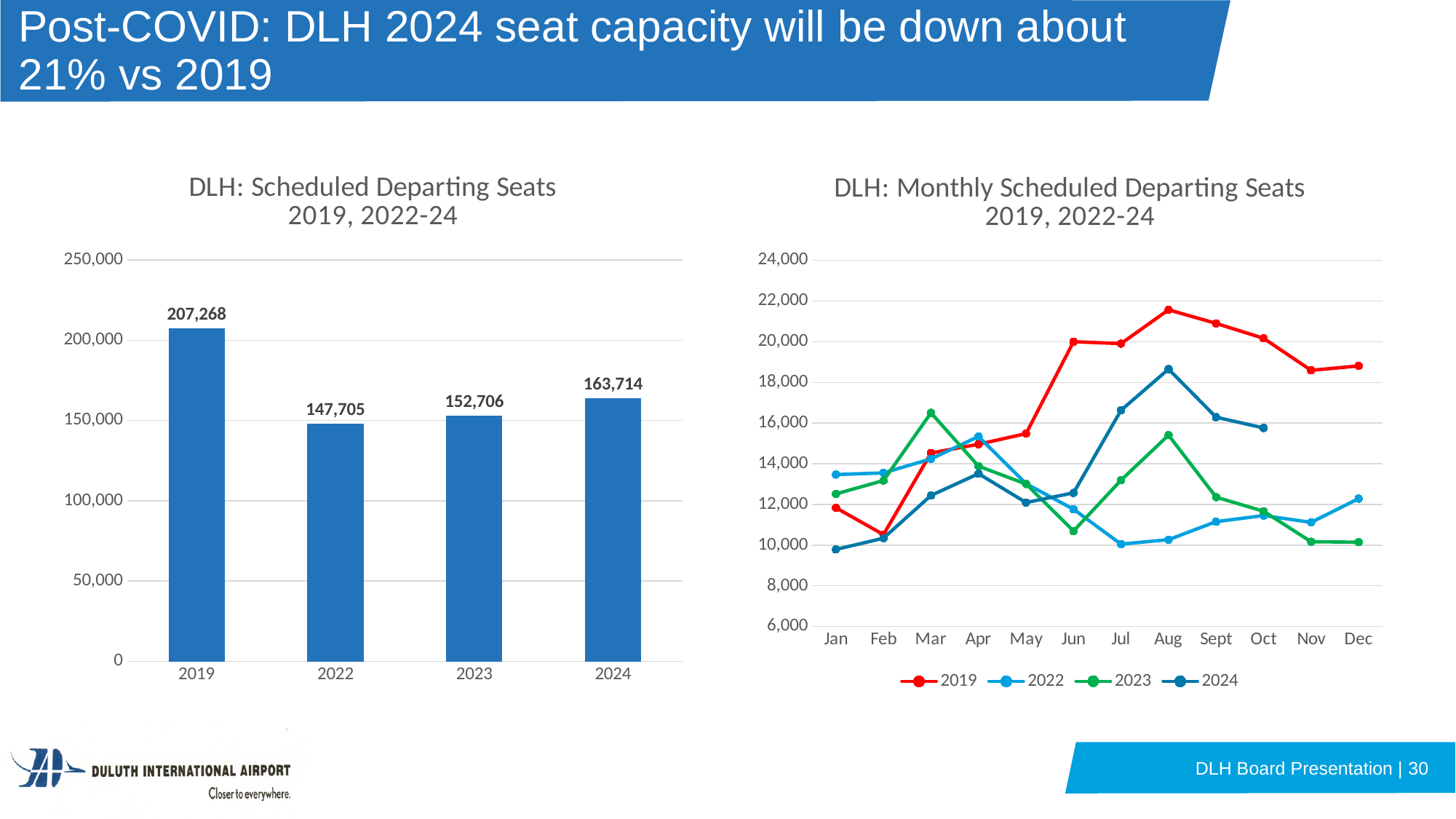
In the 'DLH: Monthly Scheduled Departing Seats' chart, is the 2024 value for Jan greater or less than 12,000? less In the 'DLH: Scheduled Departing Seats' bar chart, what is the value for 2024? 163,714 In the 'DLH: Scheduled Departing Seats' bar chart, how many bars are shown? 4 What kind of chart is the 'DLH: Scheduled Departing Seats' chart on the left? Bar chart In the 'DLH: Scheduled Departing Seats' bar chart, what is the difference between the 2023 and 2022 values? 5,001 In the 'DLH: Scheduled Departing Seats' bar chart, which year has the highest value? 2019 In the 'DLH: Scheduled Departing Seats' bar chart, which year has the lowest value? 2022 In the 'DLH: Monthly Scheduled Departing Seats' chart, is the 2019 value for Aug greater or less than 20,000? greater In the 'DLH: Monthly Scheduled Departing Seats' chart, how many series does the legend list? 4 In the 'DLH: Scheduled Departing Seats' bar chart, what is the difference between the 2019 and 2024 values? 43,554 In the 'DLH: Monthly Scheduled Departing Seats' chart, which series has the highest value in Aug? 2019 In the 'DLH: Scheduled Departing Seats' bar chart, what is the value for 2019? 207,268